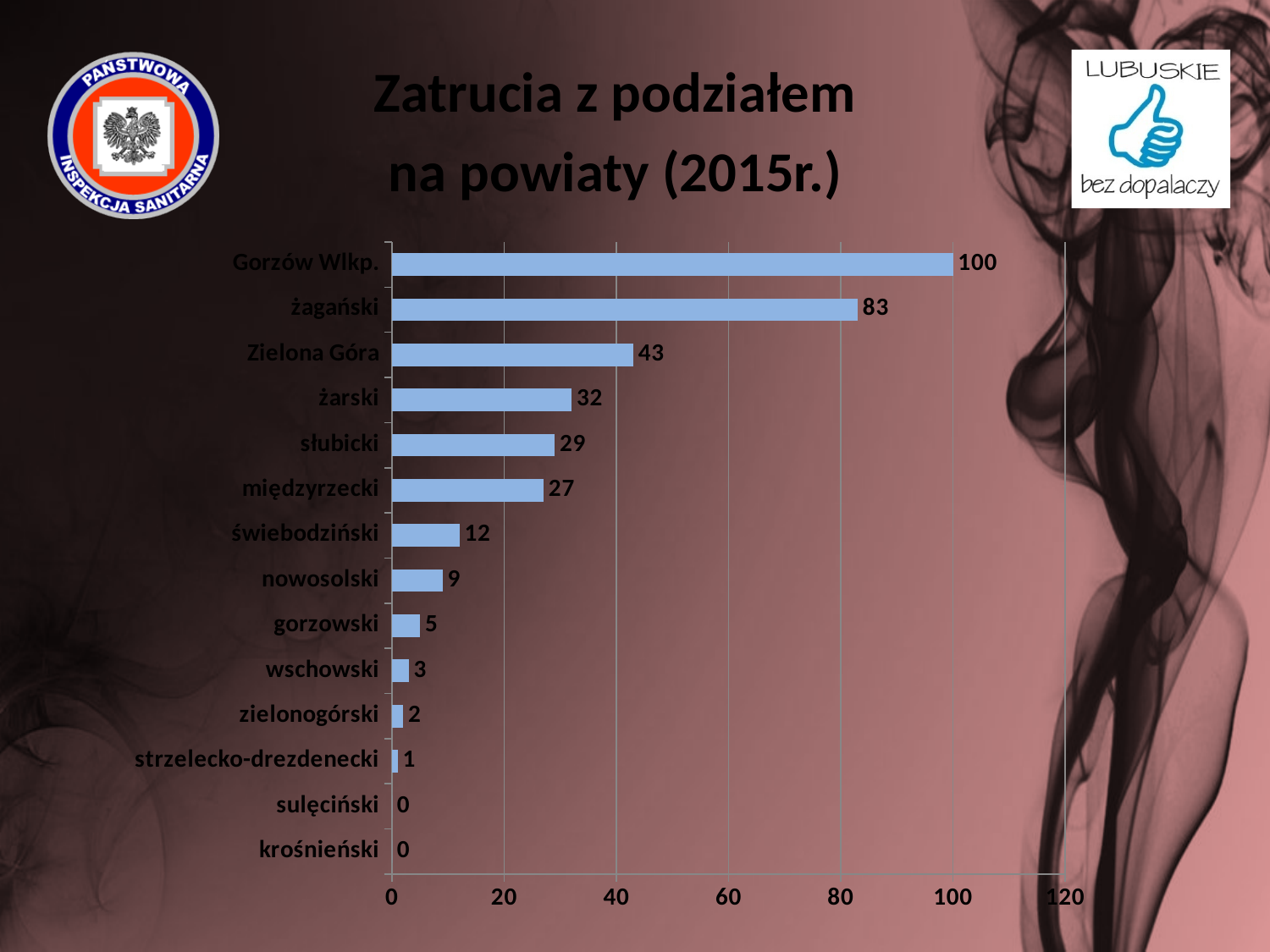
What is the value for międzyrzecki? 27 Which category has the highest value? Gorzów Wlkp. What is the difference between the values for Gorzów Wlkp. and żagański? 17 What is the difference between the values for Zielona Góra and żarski? 11 Is the value for Zielona Góra greater or less than 40? greater What is the value for nowosolski? 9 Which is larger, the value for słubicki or the value for świebodziński? słubicki What is the title of the chart? Zatrucia z podziałem na powiaty (2015r.) How many categories are shown on the chart? 14 What is the value for Gorzów Wlkp.? 100 What is the value for żagański? 83 What kind of chart is shown on the slide? bar chart